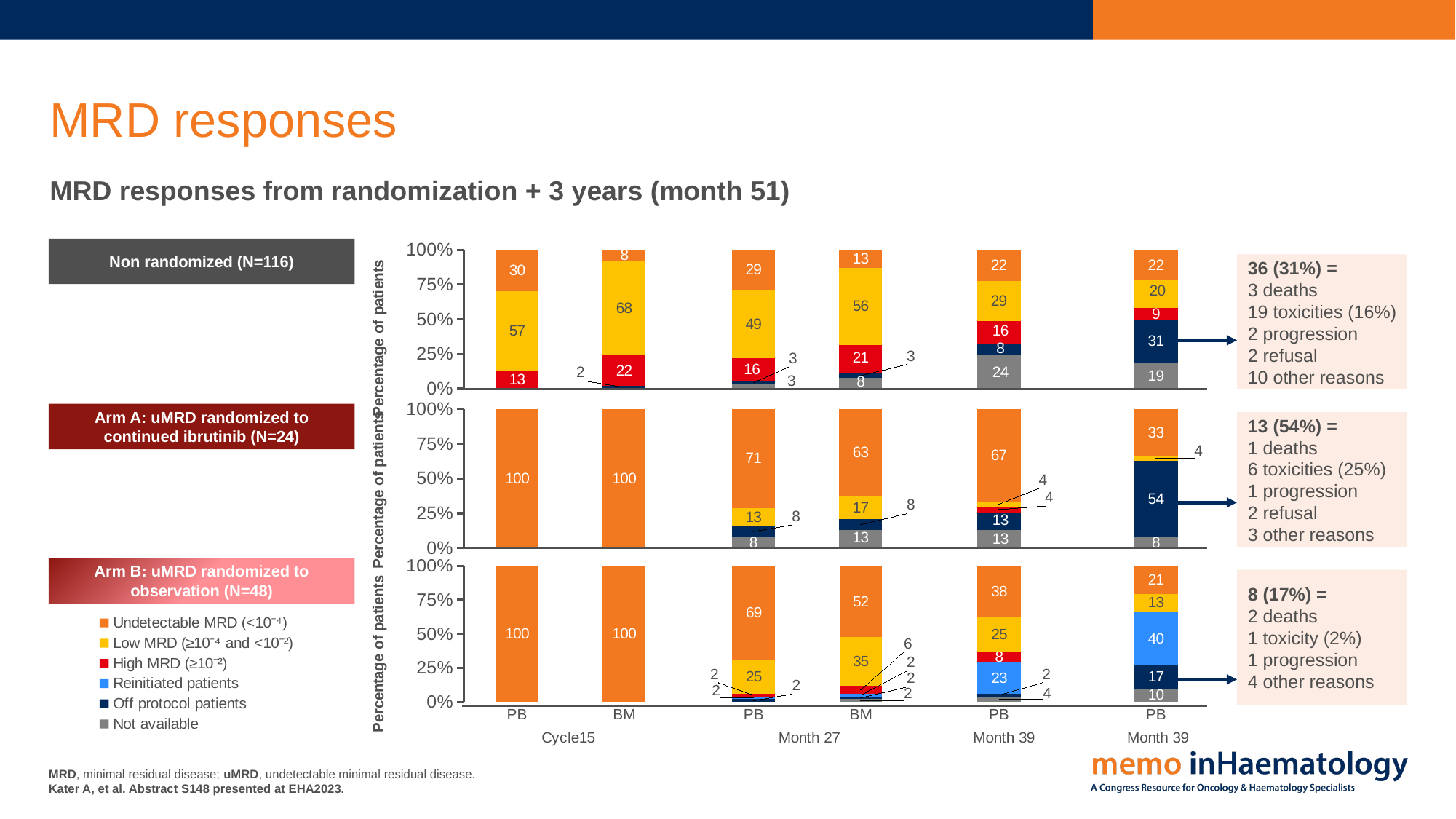
In the Arm B chart, what is the Reinitiated patients value in the rightmost PB bar? 40 In the Non randomized (N=116) chart, what is the Low MRD value for the Cycle15 BM bar? 68 What is the difference between the Undetectable MRD value for the Month 39 PB bar in the Arm A chart (67) and in the Arm B chart (38)? 29 In the Arm B chart, what is the Low MRD value for the Month 27 BM bar? 35 How many bars are plotted in the Arm B chart? 6 How many series does the legend list? 6 In the Non randomized (N=116) chart, does the Undetectable MRD value in the PB bars rise or fall from Cycle15 to Month 39? Fall In the Arm A chart, what is the Undetectable MRD value for the Cycle15 PB bar? 100 In the Non randomized (N=116) chart, what is the Undetectable MRD value for the Cycle15 PB bar? 30 In the Arm A chart, what is the Undetectable MRD value for the Month 27 PB bar? 71 In the Non randomized (N=116) chart, for the Month 27 PB bar, which is larger: the Undetectable MRD segment or the Low MRD segment? Low MRD What kind of chart is used for the Non randomized (N=116) data? Stacked bar chart